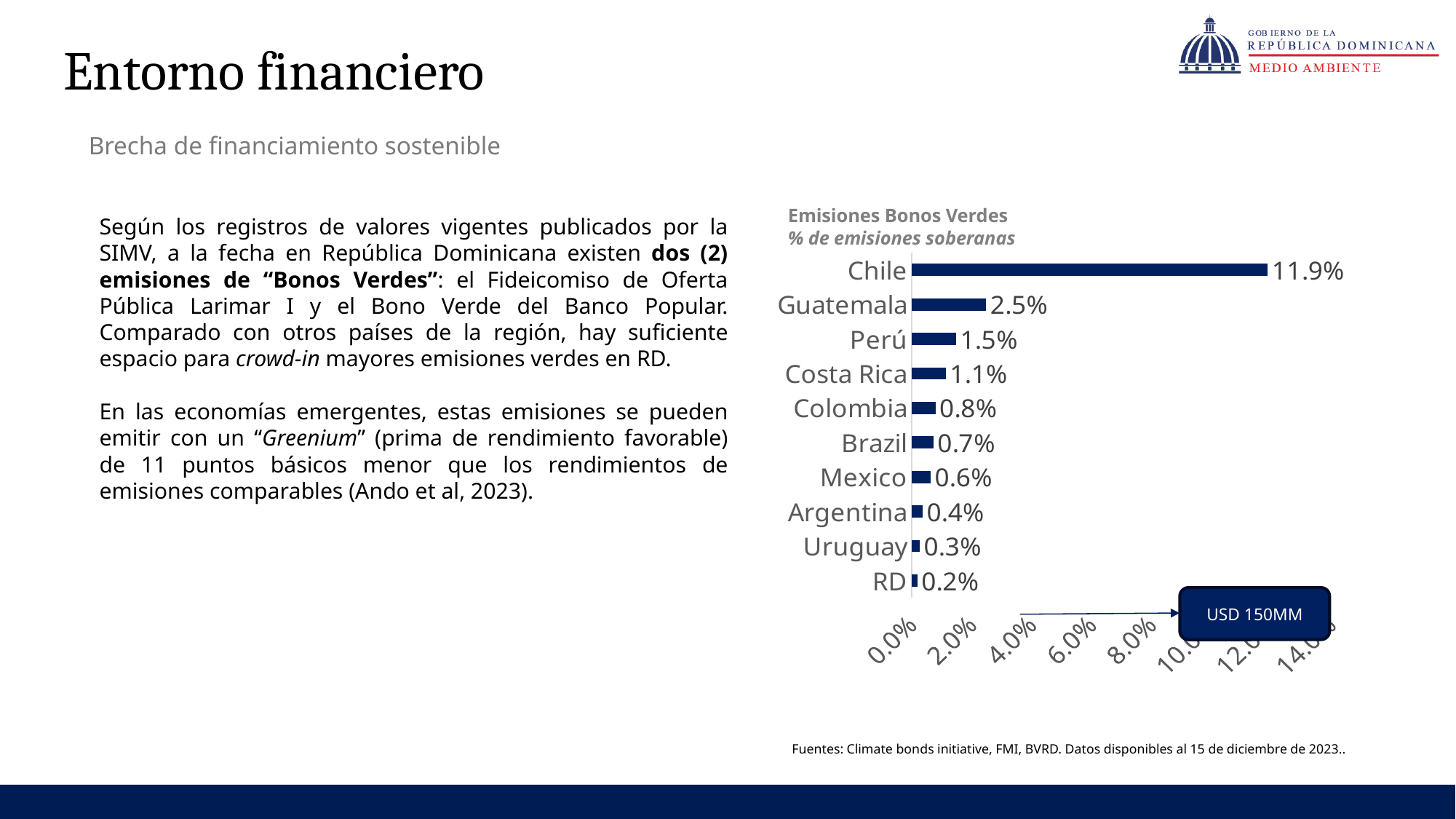
What kind of chart is the Emisiones Bonos Verdes chart? Bar chart Which has a larger value in the Emisiones Bonos Verdes chart, Perú or Colombia? Perú What is the value for Chile in the Emisiones Bonos Verdes chart? 11.9% How many countries are shown in the Emisiones Bonos Verdes chart? 10 What is the value for Costa Rica in the Emisiones Bonos Verdes chart? 1.1% What is the value for RD in the Emisiones Bonos Verdes chart? 0.2% What is the subtitle of the Emisiones Bonos Verdes chart? % de emisiones soberanas Which country has the highest value in the Emisiones Bonos Verdes chart? Chile What is the difference between the values for Chile and Guatemala in the Emisiones Bonos Verdes chart? 9.4% Which country has the lowest value in the Emisiones Bonos Verdes chart? RD What is the value for Guatemala in the Emisiones Bonos Verdes chart? 2.5% Is the value for Chile in the Emisiones Bonos Verdes chart greater or less than 10.0%? greater